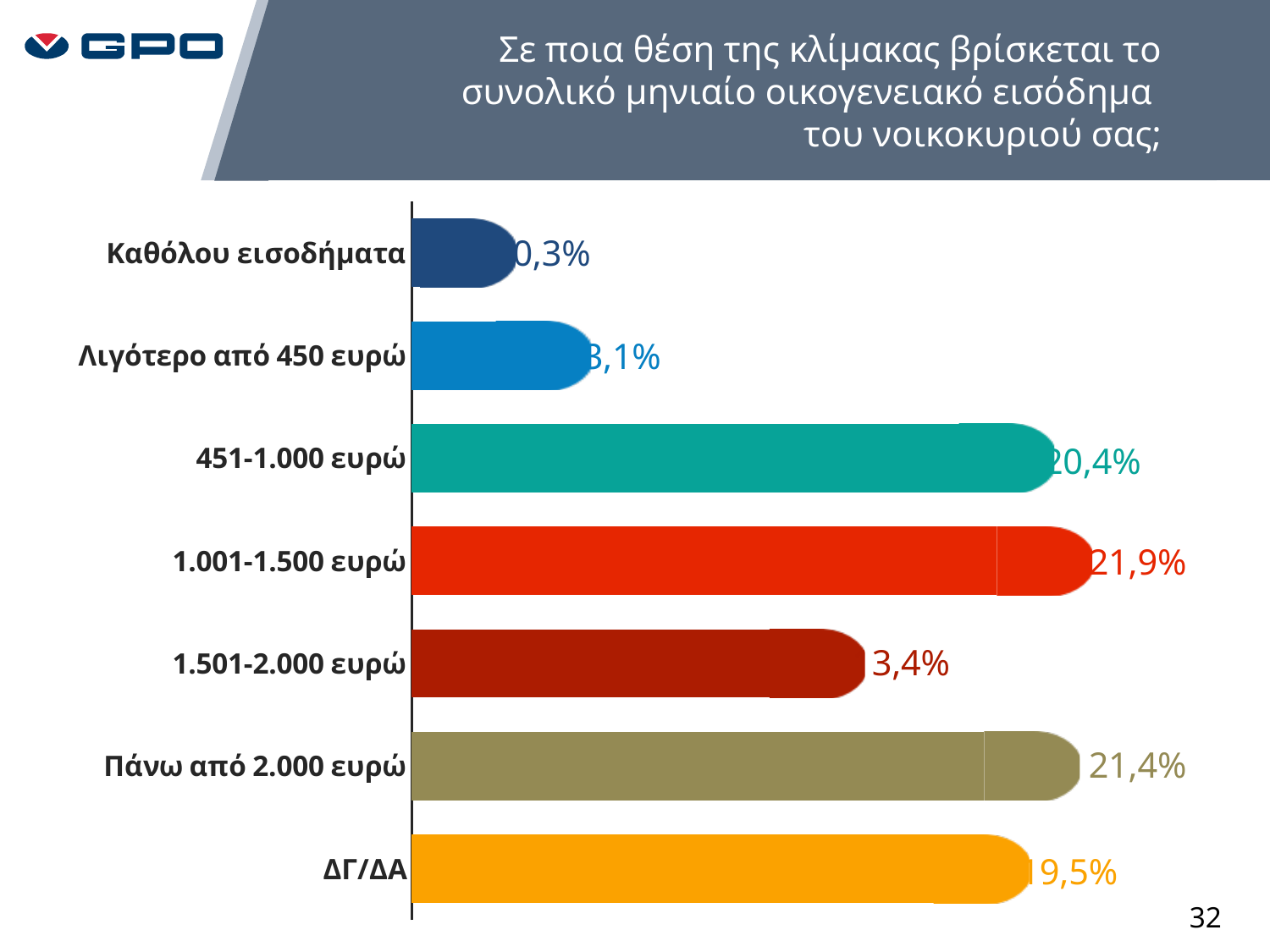
Which category has the highest percentage? 1.001-1.500 ευρώ How many categories are shown in the chart? 7 What colour is the bar for ΔΓ/ΔΑ? Orange What percentage is shown for the category 1.001-1.500 ευρώ? 21,9% Which has the larger percentage, 451-1.000 ευρώ or ΔΓ/ΔΑ? 451-1.000 ευρώ What percentage is shown for the category ΔΓ/ΔΑ? 19,5% What percentage is shown for the category Πάνω από 2.000 ευρώ? 21,4% What is the difference in percentage points between 1.001-1.500 ευρώ and 451-1.000 ευρώ? 1,5 Which category has the lowest percentage? Καθόλου εισοδήματα What is the difference in percentage points between Πάνω από 2.000 ευρώ and ΔΓ/ΔΑ? 1,9 What type of chart is shown on the slide? Bar chart What percentage is shown for the category 451-1.000 ευρώ? 20,4%